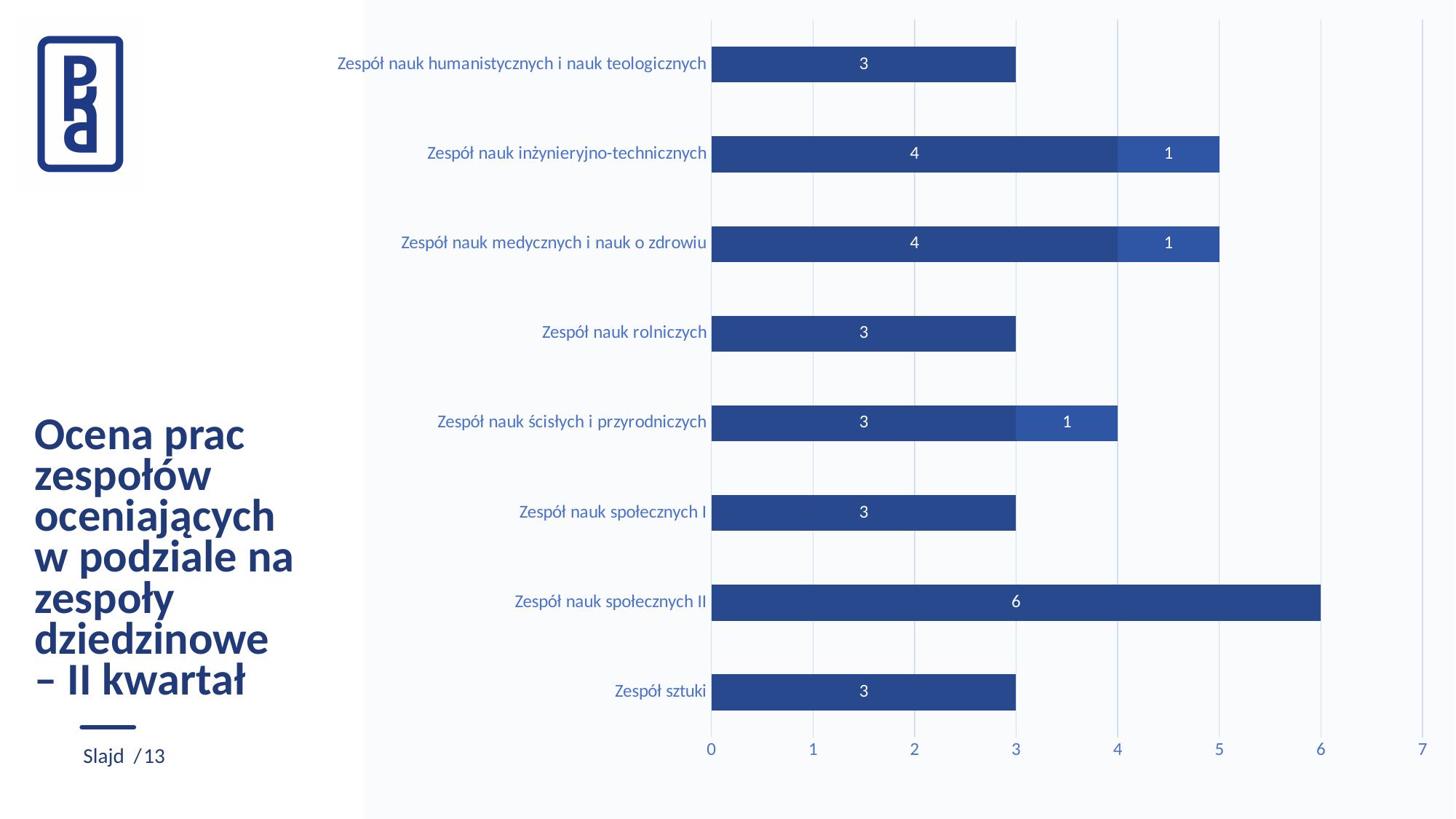
What is the difference between the total for Zespół nauk społecznych II and the total for Zespół sztuki? 3 How many categories are shown on the chart? 8 Which category has the longest bar overall? Zespół nauk społecznych II What is the total of the stacked bar for Zespół nauk medycznych i nauk o zdrowiu? 5 What is the title of the slide containing the chart? Ocena prac zespołów oceniających w podziale na zespoły dziedzinowe – II kwartał What is the value of the first (dark blue) segment for Zespół nauk społecznych II? 6 What kind of chart is shown on the slide? Stacked horizontal bar chart What is the value of the first (dark blue) segment for Zespół nauk inżynieryjno-technicznych? 4 What is the total of the stacked bar for Zespół nauk ścisłych i przyrodniczych? 4 Which bar is longer overall: Zespół nauk rolniczych or Zespół nauk inżynieryjno-technicznych? Zespół nauk inżynieryjno-technicznych Is the total value for Zespół nauk społecznych II greater or less than 5? greater What is the value of the second (lighter blue) segment for Zespół nauk ścisłych i przyrodniczych? 1